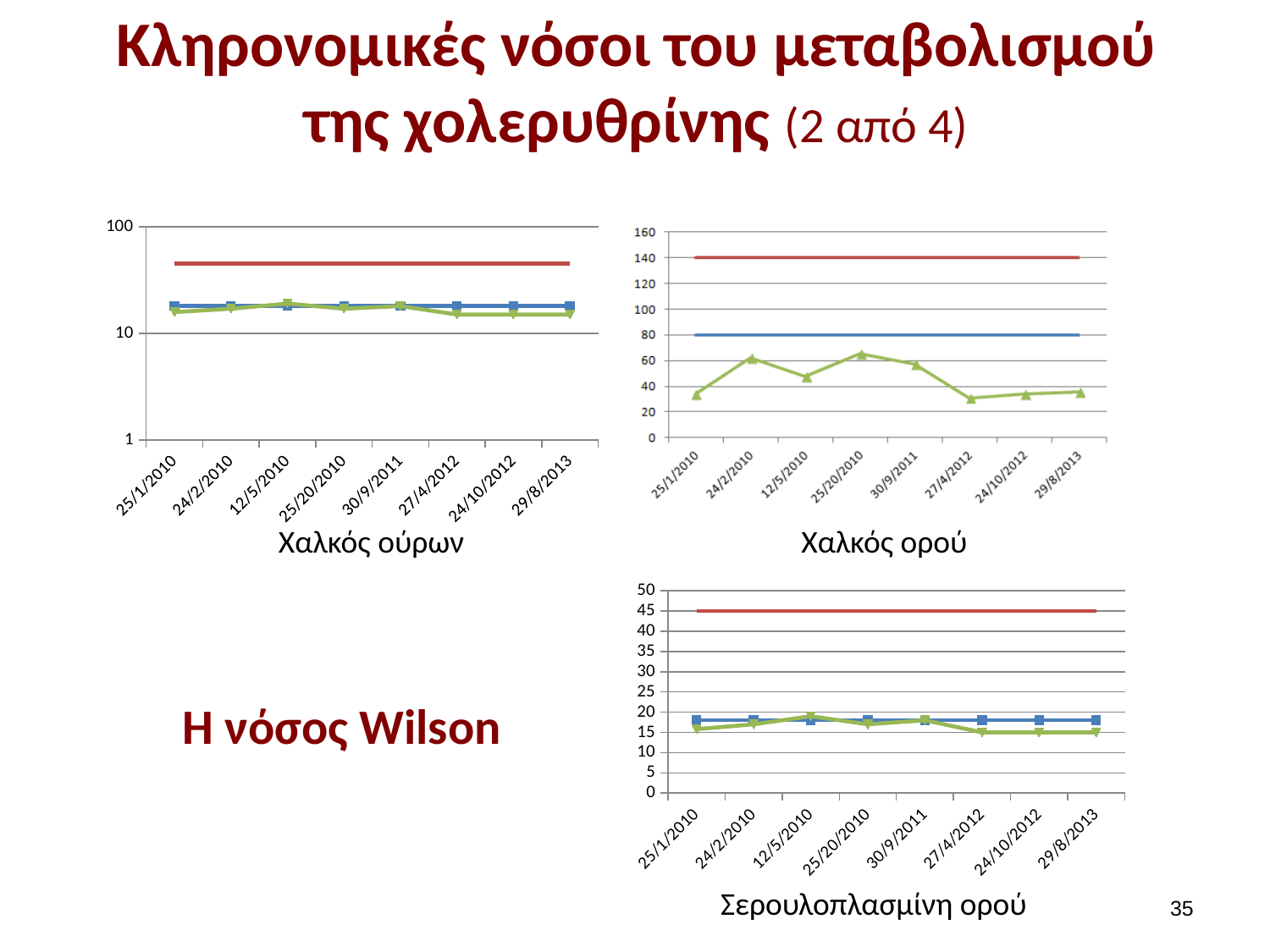
In the "Χαλκός ορού" chart, which green line value is larger: 24/2/2010 or 27/4/2012? 24/2/2010 How many charts are shown on the slide? 3 In the "Χαλκός ούρων" chart, is the red line greater or less than 100? less In the "Χαλκός ορού" chart, is the green line value for 27/4/2012 greater or less than 40? less In the "Χαλκός ορού" chart, at what value does the flat red line sit? 140 In the "Χαλκός ορού" chart, at what value does the flat blue line sit? 80 How many dates are shown on the x axis of the "Σερουλοπλασμίνη ορού" chart? 8 In the "Χαλκός ορού" chart, is the green line value for 24/2/2010 greater or less than 40? greater What kind of chart is the "Χαλκός ορού" chart? line chart In the "Σερουλοπλασμίνη ορού" chart, at what value does the flat red line sit? 45